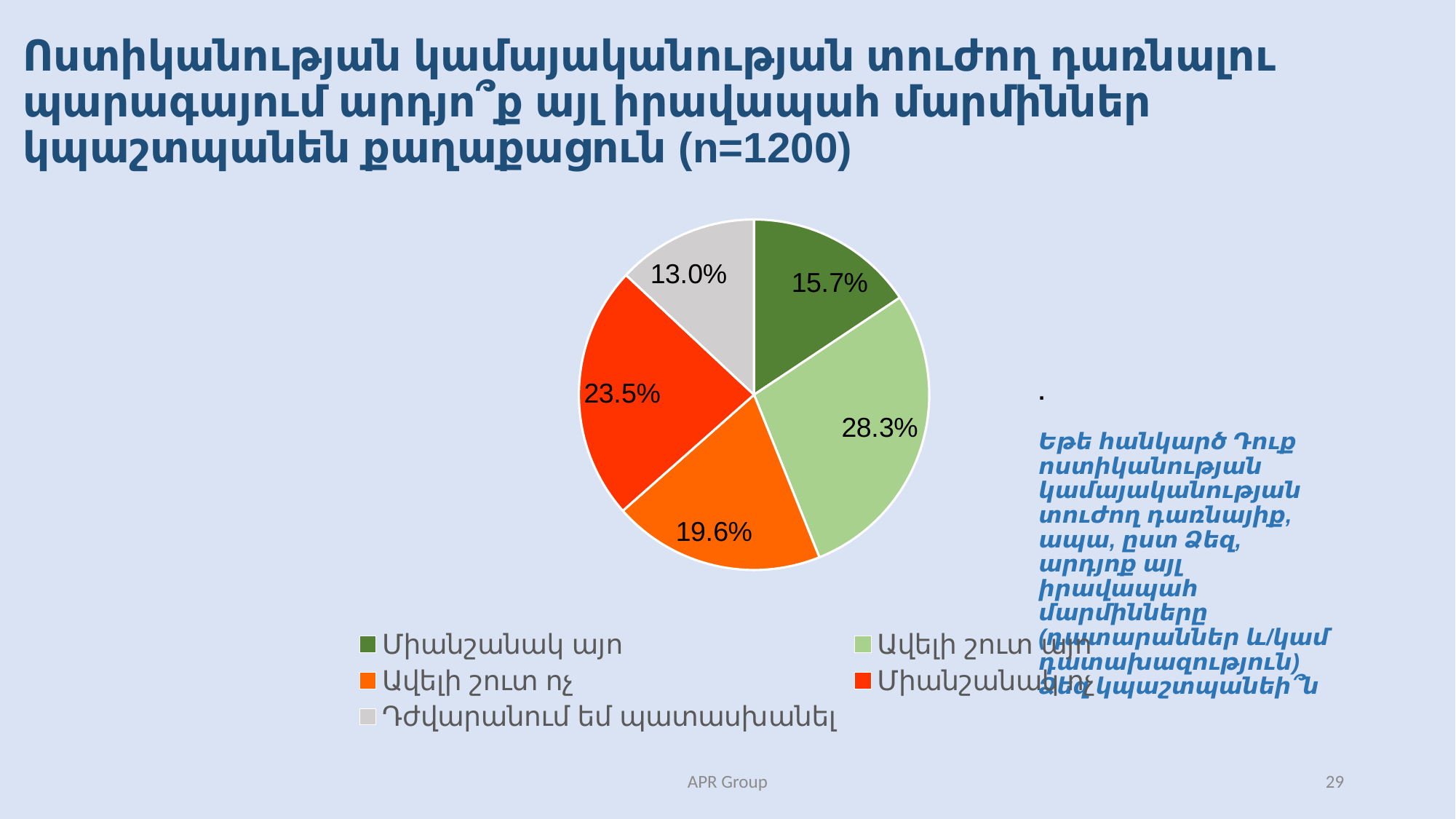
What is the difference between the "Ավելի շուտ այո" slice and the "Միանշանակ այո" slice? 12.6% What share of the pie does the slice for "Միանշանակ այո" represent? 15.7% What kind of chart is shown on the slide? pie chart What value is shown on the red slice of the pie chart? 23.5% How many slices does the pie chart have? 5 Which is larger: the "Ավելի շուտ ոչ" slice or the "Դժվարանում եմ պատասխանել" slice? Ավելի շուտ ոչ Which slice of the pie chart is the largest? Ավելի շուտ այո What share of the pie does the slice for "Ավելի շուտ այո" represent? 28.3% What colour is the slice for "Դժվարանում եմ պատասխանել"? grey Which slice of the pie chart is the smallest? Դժվարանում եմ պատասխանել What share of the pie does the slice for "Դժվարանում եմ պատասխանել" represent? 13.0% What share of the pie does the slice for "Ավելի շուտ ոչ" represent? 19.6%